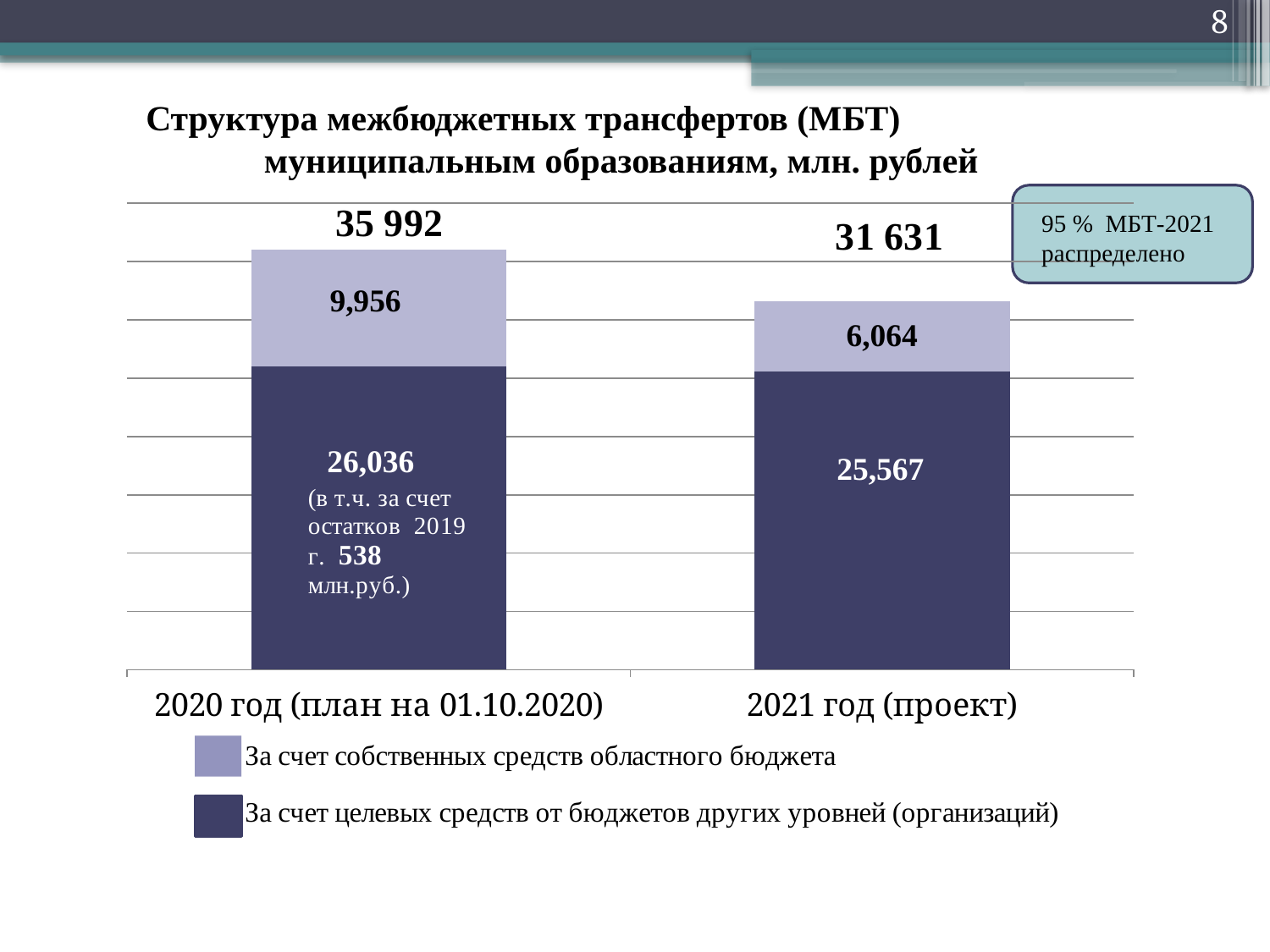
Is the 'За счет целевых средств' value larger in 2020 or in 2021? 2020 What is the total of the stacked bar for 2020 год (план на 01.10.2020)? 35 992 What is the difference between the 'За счет собственных средств областного бюджета' values for 2020 and 2021? 3,892 What is the total of the stacked bar for 2021 год (проект)? 31 631 What type of chart is shown on the slide? stacked bar chart What is the difference between the 'За счет целевых средств от бюджетов других уровней (организаций)' values for 2020 and 2021? 469 What is the value for 'За счет собственных средств областного бюджета' in 2020 год (план на 01.10.2020)? 9,956 How many categories are shown on the x axis? 2 Which year has the higher total of interbudget transfers? 2020 год (план на 01.10.2020) What is the value for 'За счет собственных средств областного бюджета' in 2021 год (проект)? 6,064 How many series does the legend list? 2 What is the value for 'За счет целевых средств от бюджетов других уровней (организаций)' in 2021 год (проект)? 25,567